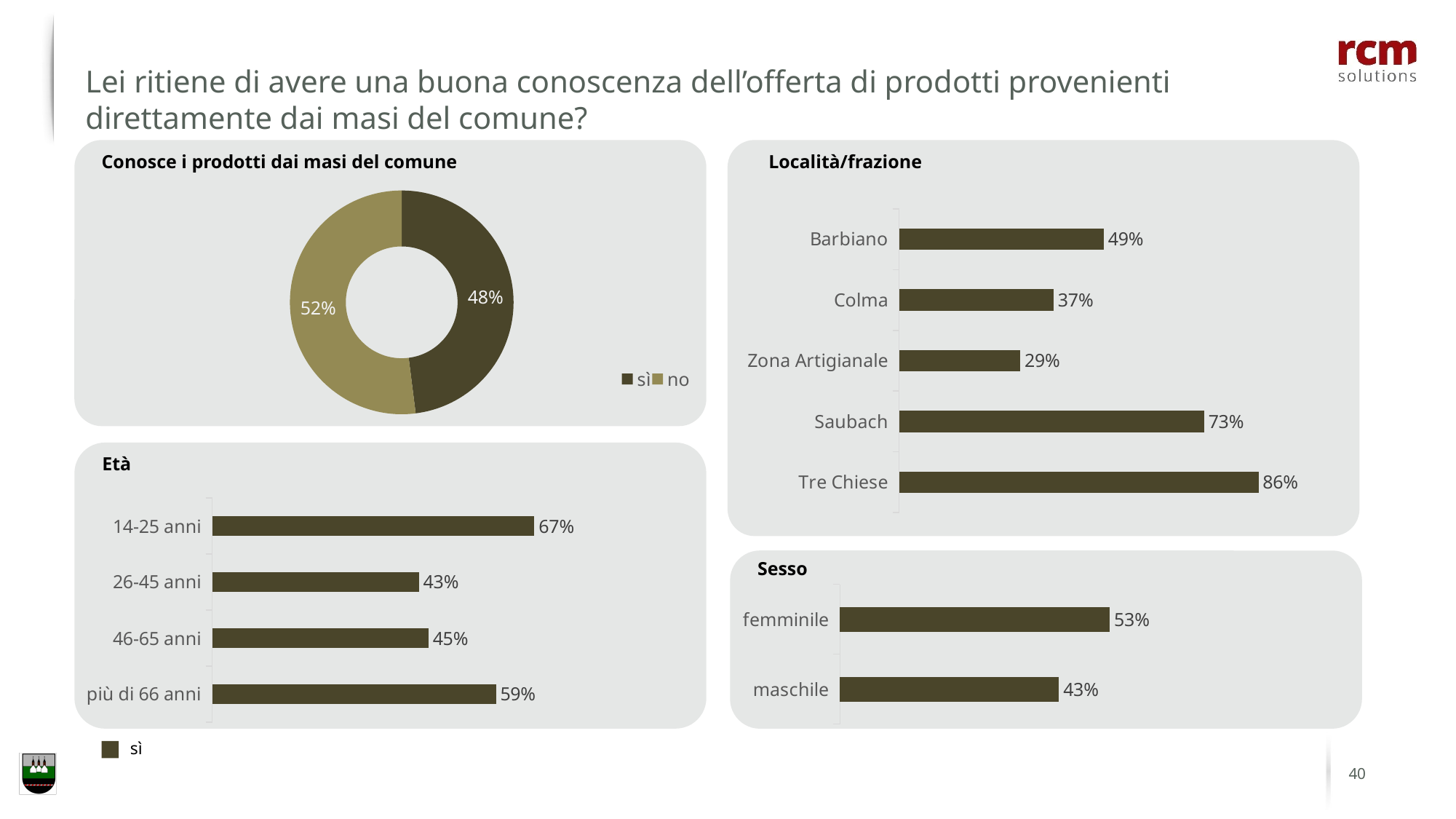
In the 'Località/frazione' chart, which locality has the highest value? Tre Chiese How many localities are shown in the 'Località/frazione' chart? 5 In the 'Sesso' chart, what is the difference between femminile and maschile? 10% In the 'Località/frazione' chart, what is the difference between Barbiano and Colma? 12% In the 'Località/frazione' chart, what is the value for Saubach? 73% In the 'Sesso' chart, which is larger, femminile or maschile? femminile In the 'Conosce i prodotti dai masi del comune' chart, what share of respondents answered 'sì'? 48% In the 'Località/frazione' chart, which locality has the lowest value? Zona Artigianale In the 'Età' chart, which age group has the highest value? 14-25 anni In the 'Conosce i prodotti dai masi del comune' chart, what share of respondents answered 'no'? 52% What kind of chart is the 'Conosce i prodotti dai masi del comune' chart? Doughnut chart In the 'Età' chart, what is the value for 'più di 66 anni'? 59%